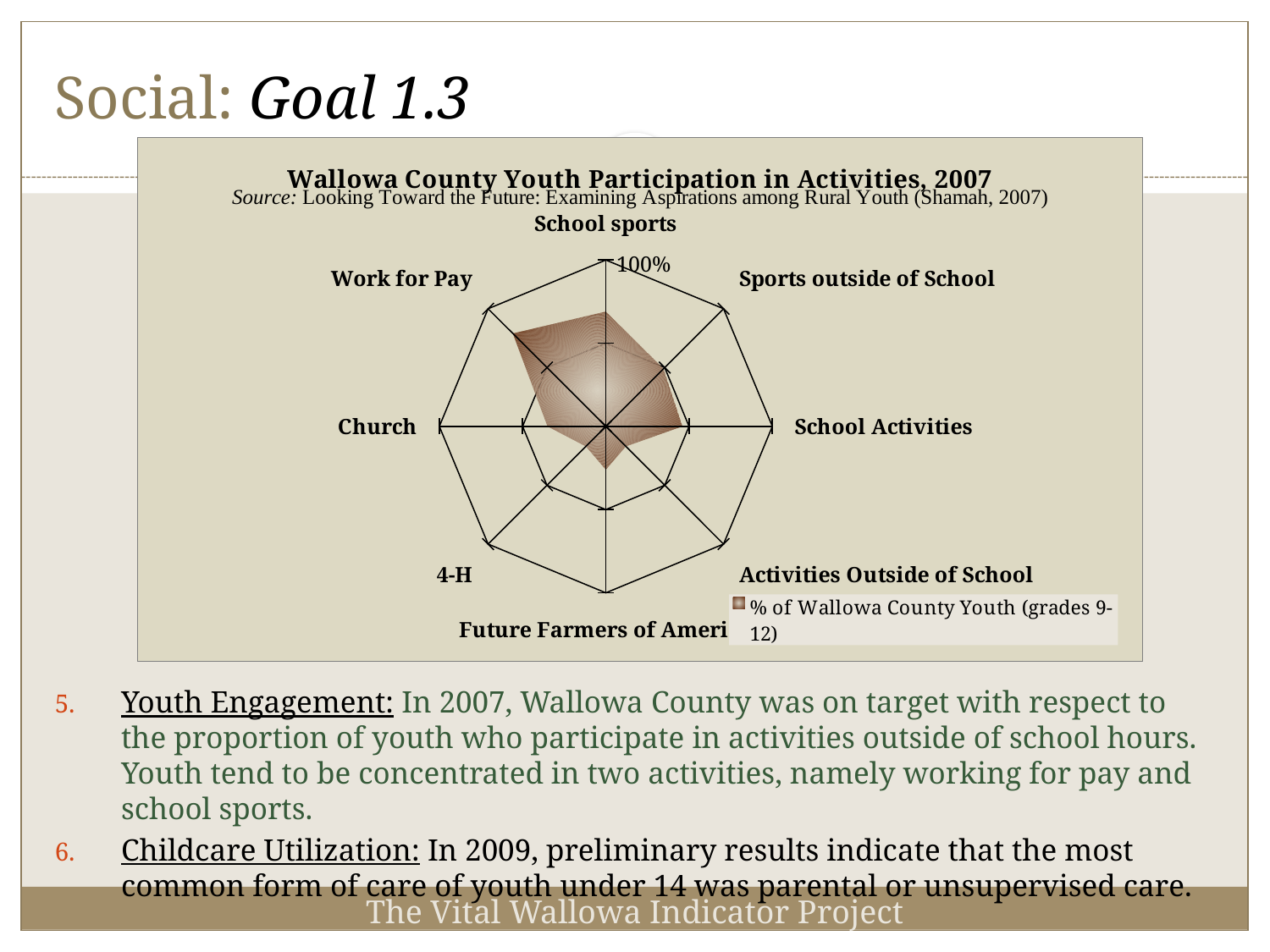
Which is larger, the value for Work for Pay or the value for Sports outside of School? Work for Pay What kind of chart is shown on the slide? Radar chart What is the title of the chart? Wallowa County Youth Participation in Activities, 2007 Which is larger, the value for School sports or the value for Future Farmers of America? School sports What series name is shown in the chart legend? % of Wallowa County Youth (grades 9-12) How many series does the chart legend list? 1 Is the value for School sports greater or less than 100%? less Which is larger, the value for School Activities or the value for Activities Outside of School? School Activities How many activity categories are plotted on the radar chart? 8 Is the value for Work for Pay greater or less than 100%? less